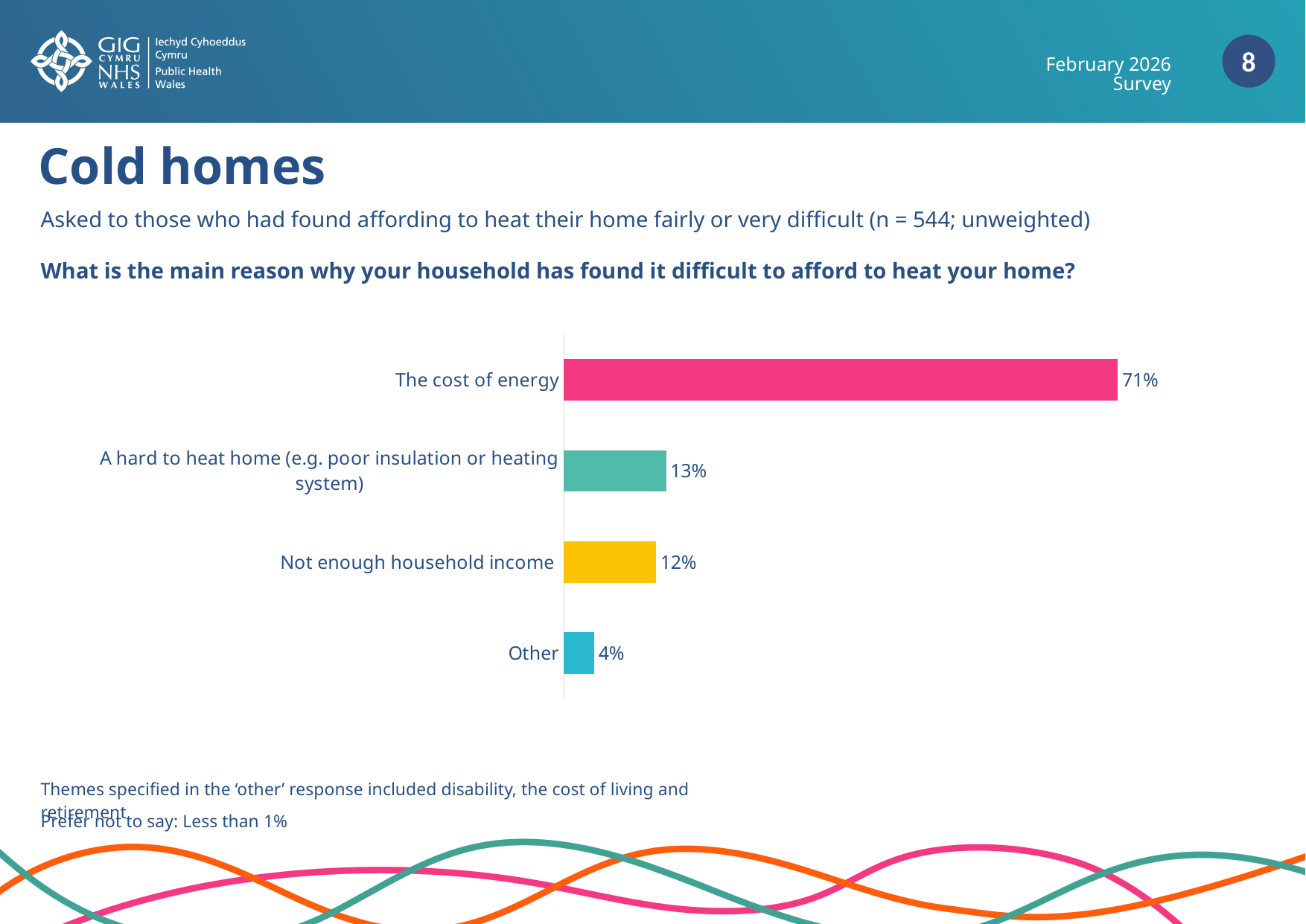
What colour is the bar for 'The cost of energy'? Pink What is the value for 'Not enough household income'? 12% What is the value for 'A hard to heat home (e.g. poor insulation or heating system)'? 13% What is the value for 'Other'? 4% Which reason has the lowest percentage? Other What percentage of respondents gave 'The cost of energy' as the main reason? 71% What is the difference between 'Not enough household income' and 'Other'? 8 percentage points Which is larger: the value for 'The cost of energy' or the value for 'Not enough household income'? The cost of energy What kind of chart is shown on the slide? Bar chart How many reason categories are shown in the chart? 4 Which reason has the highest percentage? The cost of energy What is the difference in percentage points between 'The cost of energy' and 'A hard to heat home (e.g. poor insulation or heating system)'? 58 percentage points